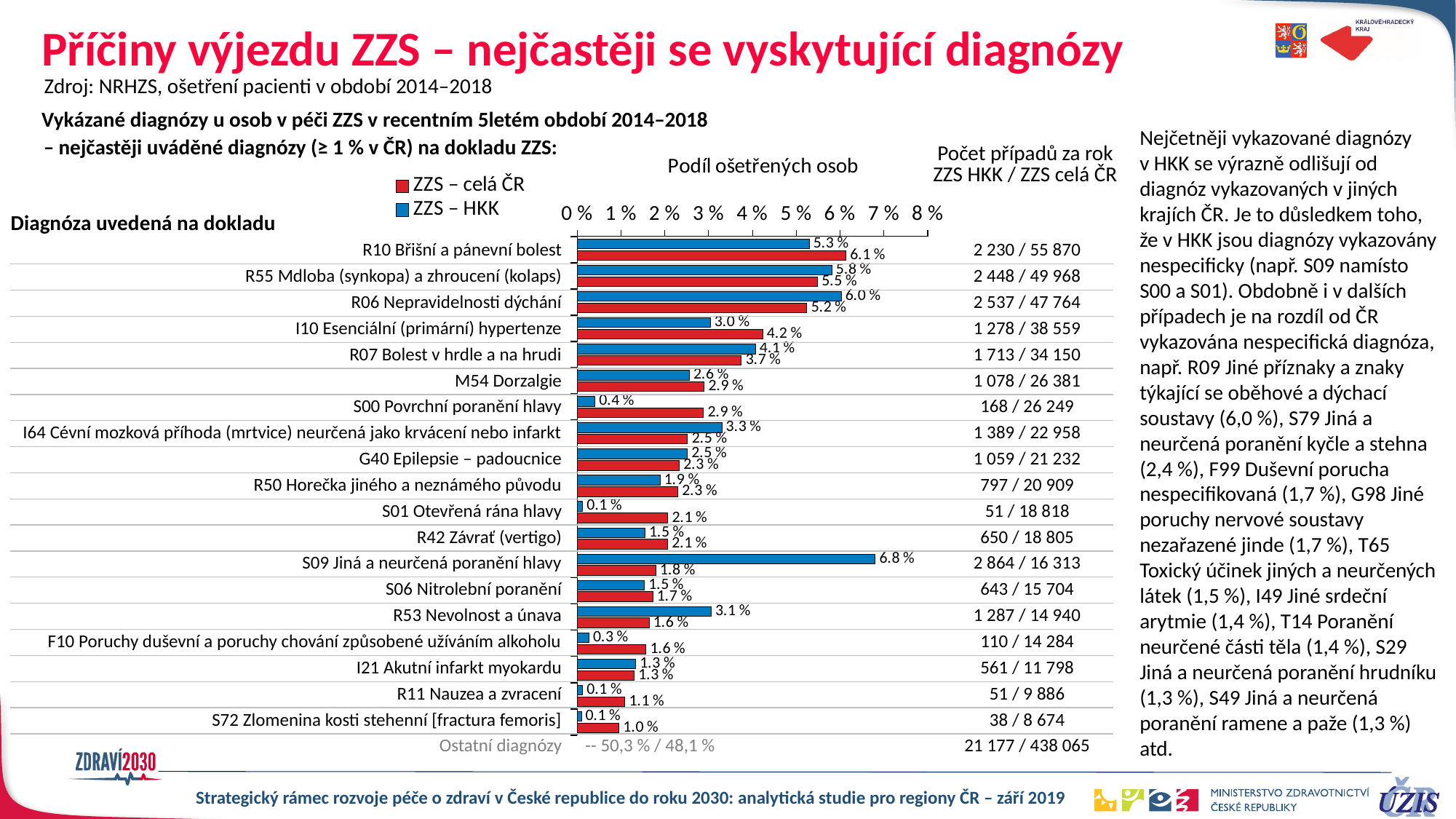
What is the ZZS – HKK value for R06 Nepravidelnosti dýchání? 6.0 % What is the difference between the ZZS – HKK and ZZS – celá ČR values for S09 Jiná a neurčená poranění hlavy? 5.0 % What is the ZZS – celá ČR value for I10 Esenciální (primární) hypertenze? 4.2 % What type of chart is shown on the slide? bar chart What is the ZZS – celá ČR value for R10 Břišní a pánevní bolest? 6.1 % How many diagnoses (categories) are plotted in the bar chart, excluding the 'Ostatní diagnózy' row? 19 Which diagnosis has the highest ZZS – HKK value? S09 Jiná a neurčená poranění hlavy What is the ZZS – HKK value for S09 Jiná a neurčená poranění hlavy? 6.8 % Which diagnosis has the lowest ZZS – celá ČR value? S72 Zlomenina kosti stehenní [fractura femoris] How many series does the chart legend list? 2 For S00 Povrchní poranění hlavy, which series has the larger value, ZZS – celá ČR or ZZS – HKK? ZZS – celá ČR What are the two series named in the chart legend? ZZS – celá ČR and ZZS – HKK